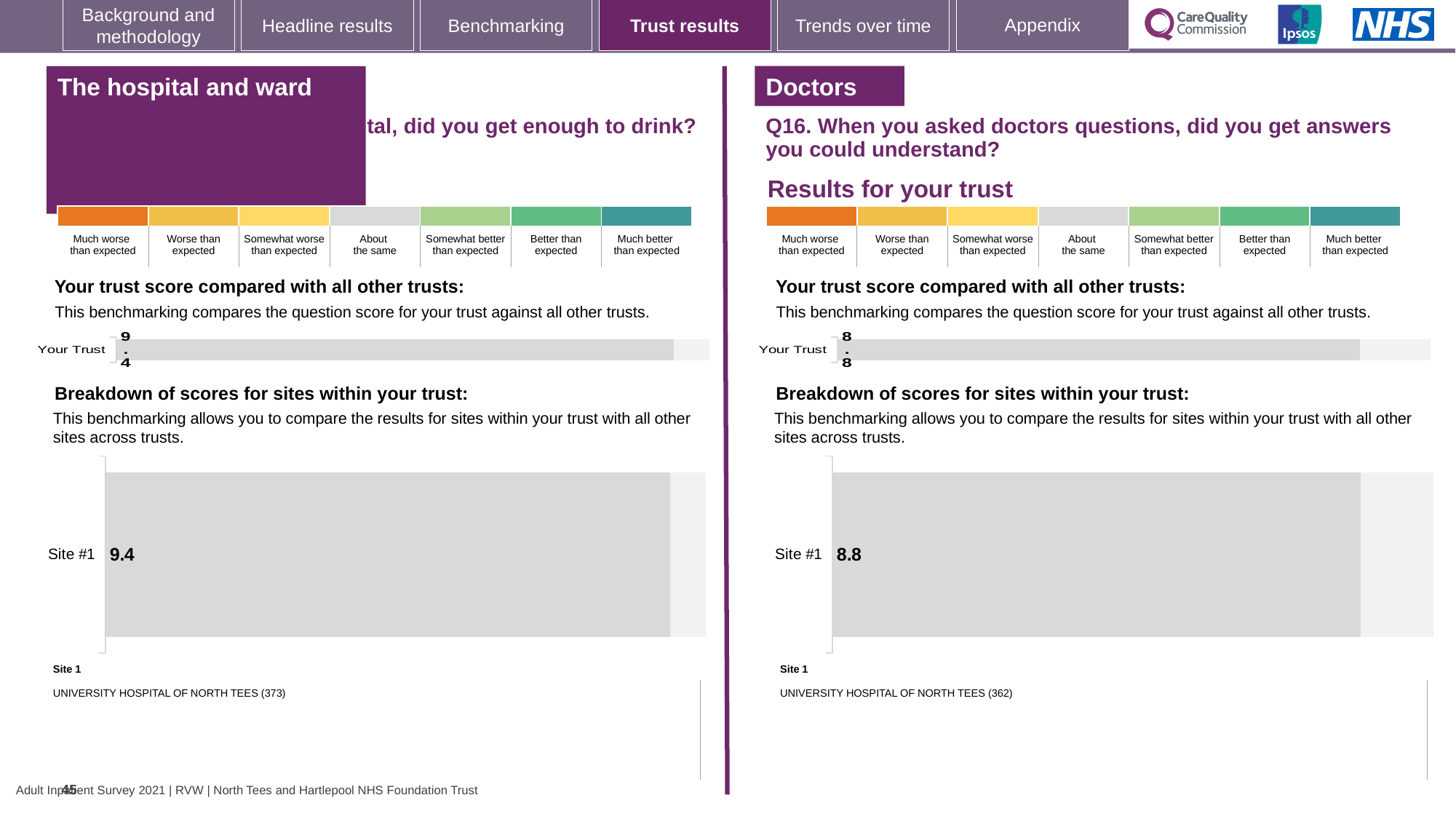
In the left-hand 'Breakdown of scores for sites within your trust' chart, what is the score for Site #1? 9.4 On the right-hand side of the slide (Q16, Doctors), what is the 'Your Trust' score shown in the 'Your trust score compared with all other trusts' chart? 8.8 Which site name is listed as Site 1 beneath the left-hand breakdown chart? UNIVERSITY HOSPITAL OF NORTH TEES (373) Which site name is listed as Site 1 beneath the right-hand Q16 breakdown chart? UNIVERSITY HOSPITAL OF NORTH TEES (362) How many sites are plotted in the right-hand Q16 'Breakdown of scores for sites within your trust' chart? 1 What is the difference between the Site #1 score in the left-hand breakdown chart and the Site #1 score in the right-hand Q16 breakdown chart? 0.6 What type of chart is used to show the 'Your Trust' score on the left-hand side of the slide? Bar chart Which is larger: the 'Your Trust' score in the left-hand chart or the 'Your Trust' score in the right-hand Q16 chart? The left-hand chart (9.4) What type of chart is used for the 'Breakdown of scores for sites within your trust' on the right-hand side of the slide? Bar chart How many sites are plotted in the left-hand 'Breakdown of scores for sites within your trust' chart? 1 On the left-hand side of the slide, what is the 'Your Trust' score shown in the 'Your trust score compared with all other trusts' chart? 9.4 In the right-hand 'Breakdown of scores for sites within your trust' chart (Q16), what is the score for Site #1? 8.8